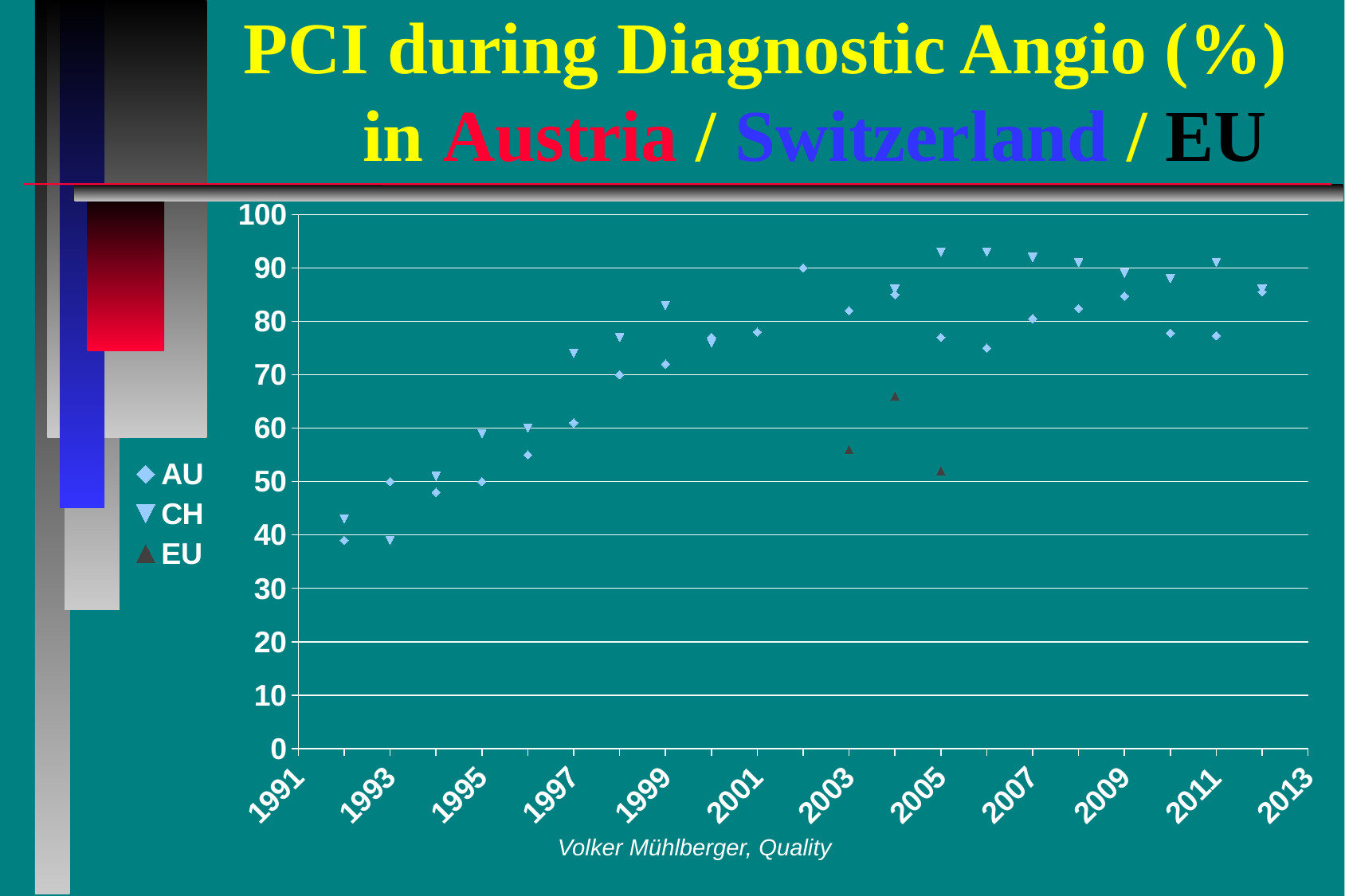
How many series does the legend list? 3 How many data points are plotted for the EU series? 3 Is the EU value for 2003 greater or less than 60? less Which series has the highest value in 2005? CH In 2004, which is larger: the AU value or the EU value? AU Do the AU values generally rise or fall from 1992 to 2002? rise What are the three series named in the legend? AU, CH, EU Is the CH value for 2005 greater or less than 90? greater Is the AU value for 1992 greater or less than 50? less What kind of chart is shown on the slide? scatter chart